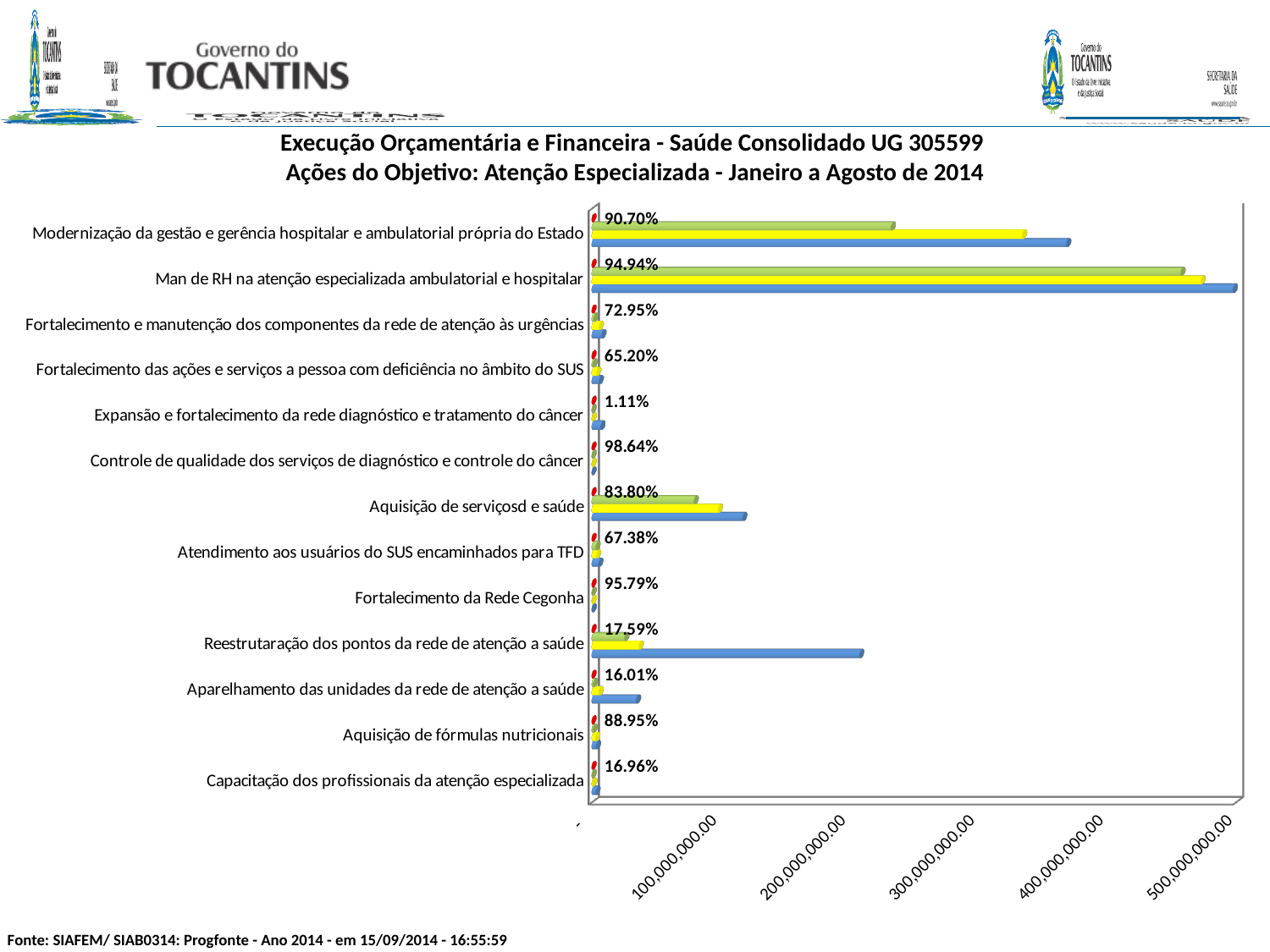
Which category has the lowest percentage label? Expansão e fortalecimento da rede diagnóstico e tratamento do câncer What percentage is shown for "Fortalecimento da Rede Cegonha"? 95.79% What percentage is shown for "Controle de qualidade dos serviços de diagnóstico e controle do câncer"? 98.64% What is the difference between the percentage labels for "Man de RH na atenção especializada ambulatorial e hospitalar" and "Modernização da gestão e gerência hospitalar e ambulatorial própria do Estado"? 4.24% Is the blue bar for "Man de RH na atenção especializada ambulatorial e hospitalar" greater or less than 400,000,000.00? greater What percentage is shown for "Aparelhamento das unidades da rede de atenção a saúde"? 16.01% Which category has the highest percentage label? Controle de qualidade dos serviços de diagnóstico e controle do câncer Is the blue bar for "Aquisição de serviçosd e saúde" greater or less than 200,000,000.00? less How many categories are listed on the vertical axis of the chart? 13 What kind of chart is shown on the slide? Bar chart Which has the larger percentage label: "Aquisição de serviçosd e saúde" or "Atendimento aos usuários do SUS encaminhados para TFD"? Aquisição de serviçosd e saúde What period does the chart title say the data covers? Janeiro a Agosto de 2014